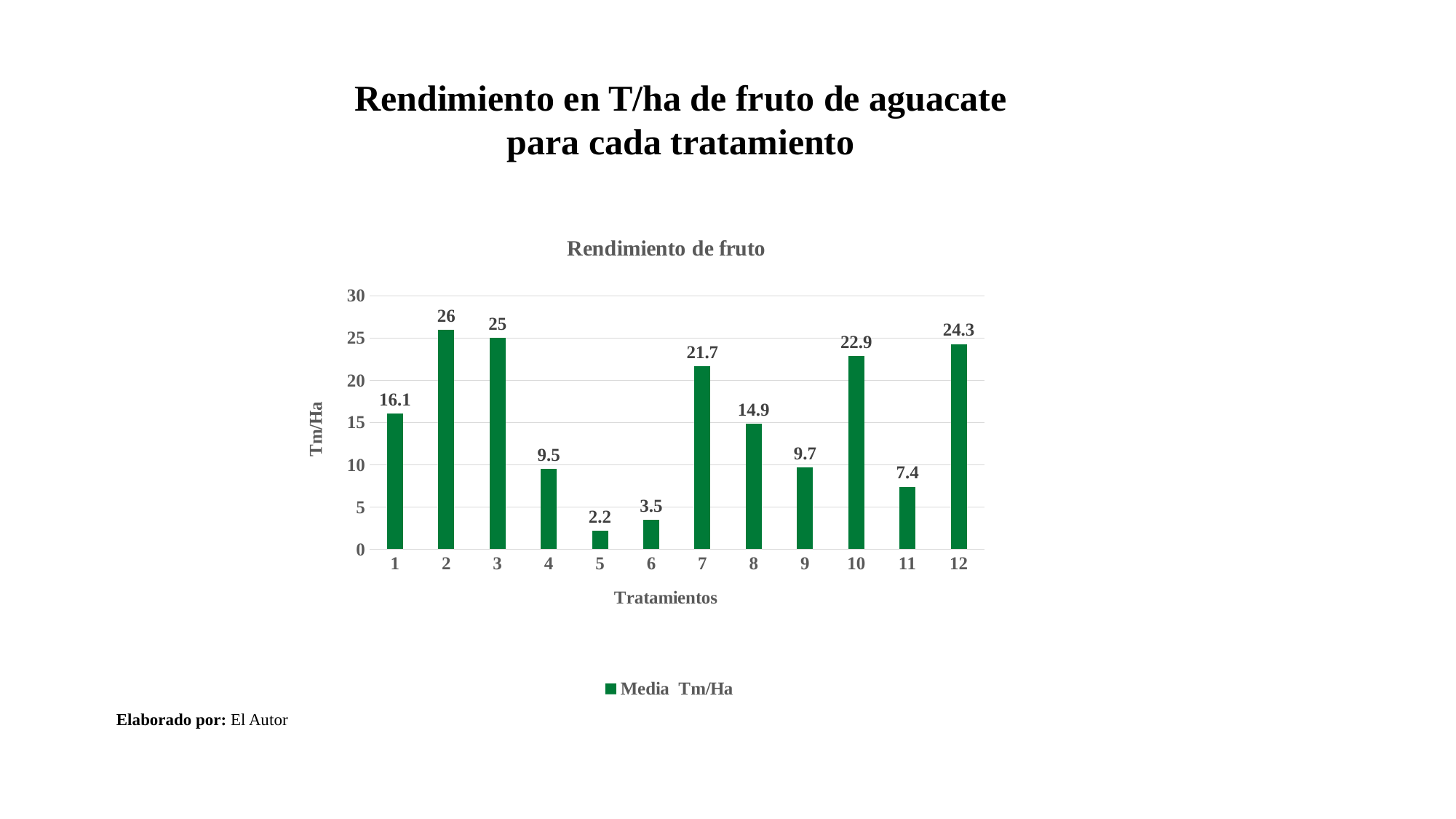
What is the difference between the values for tratamiento 12 and tratamiento 10? 1.4 How many tratamientos are shown on the x axis? 12 What is the difference between the values for tratamiento 2 and tratamiento 3? 1 Is the value for tratamiento 8 greater or less than 15? less Which has a larger value, tratamiento 4 or tratamiento 9? 9 Which tratamiento has the highest value? 2 How many series does the legend list? 1 What is the label on the y axis? Tm/Ha What is the value for tratamiento 7? 21.7 What kind of chart is shown? bar chart What is the value for tratamiento 11? 7.4 Which tratamiento has the lowest value? 5